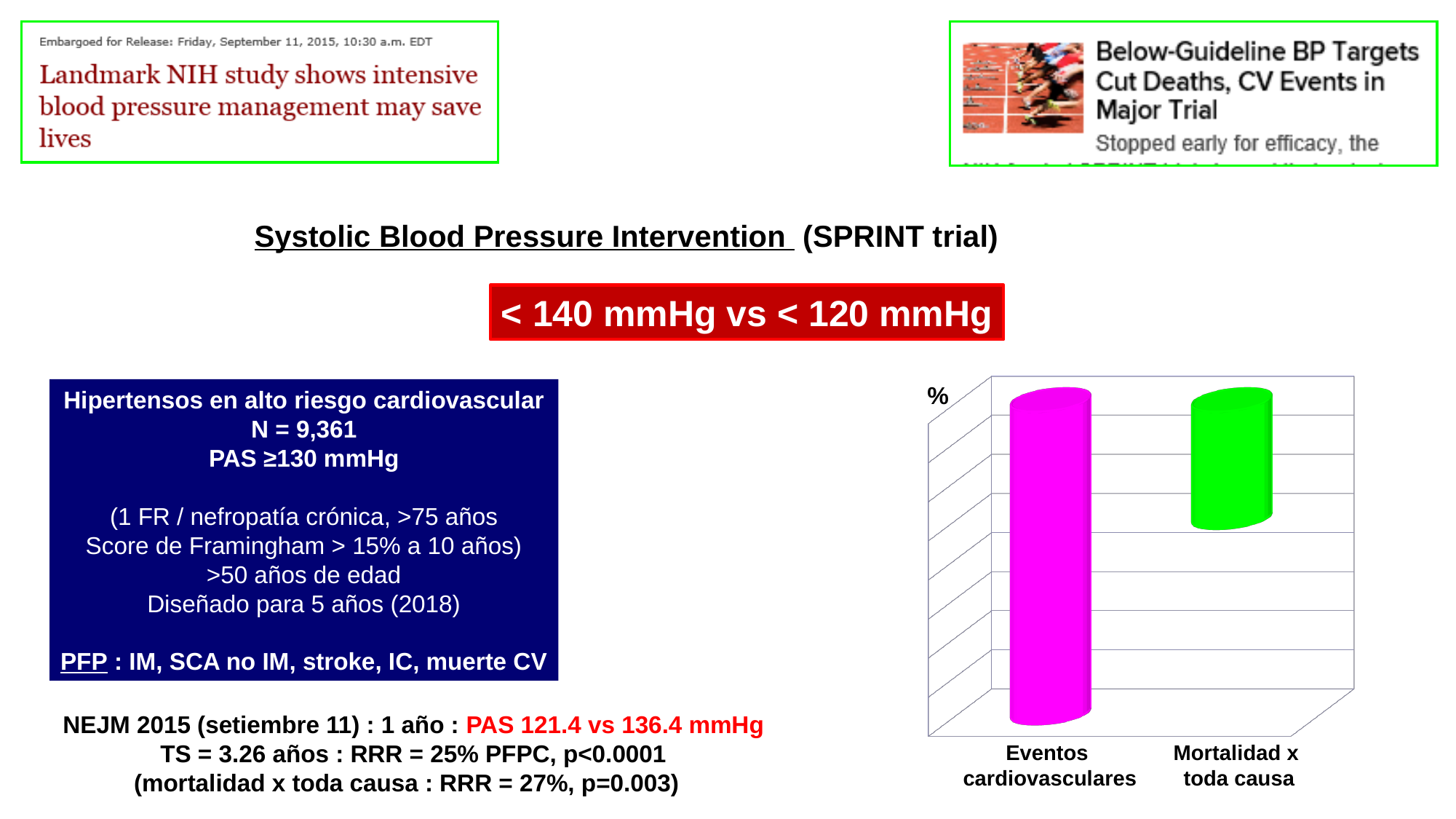
What kind of chart is shown on the right side of the slide? bar chart Which category has the tallest bar in the chart? Eventos cardiovasculares What colour is the bar for Eventos cardiovasculares? magenta Which category has the shortest bar in the chart? Mortalidad x toda causa How many categories are plotted in the bar chart? 2 Which bar is taller, Eventos cardiovasculares or Mortalidad x toda causa? Eventos cardiovasculares What label is shown on the vertical axis of the chart? %